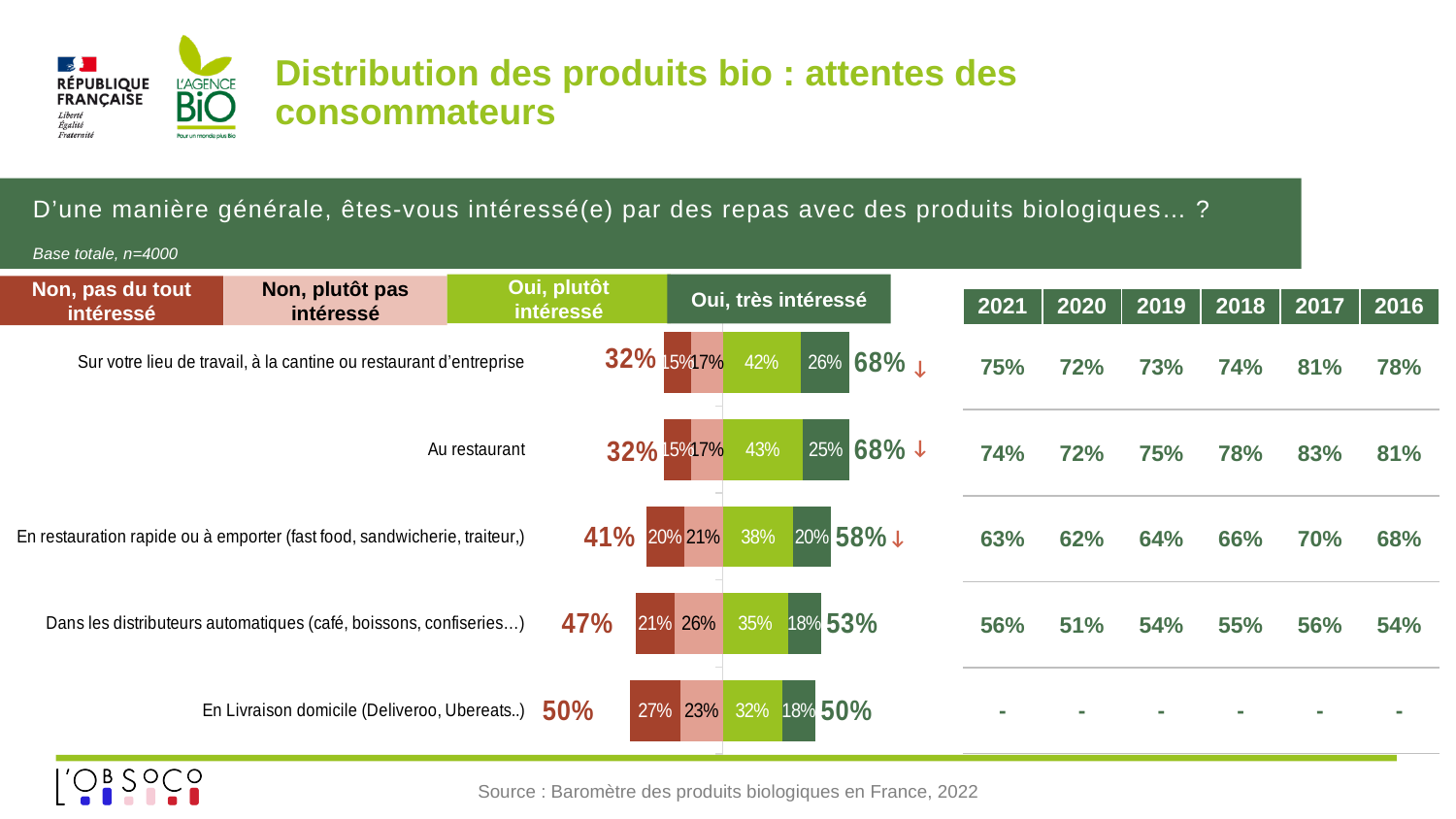
Which category has the lowest 'Oui, plutôt intéressé' value? En Livraison domicile (Deliveroo, Ubereats..) Going from the top category to the bottom category, does the 'Oui, très intéressé' value rise or fall? Fall How many categories (places) are shown in the stacked bar chart? 5 Which has the larger 'Non, plutôt pas intéressé' value: 'Dans les distributeurs automatiques' or 'En Livraison domicile'? Dans les distributeurs automatiques What is the combined 'Oui' (plutôt + très intéressé) total for 'En restauration rapide ou à emporter (fast food, sandwicherie, traiteur,)'? 58% How many series does the legend of the stacked bar chart list? 4 What is the 'Oui, plutôt intéressé' value for 'Au restaurant'? 43% What is the 'Non, pas du tout intéressé' value for 'En Livraison domicile (Deliveroo, Ubereats..)'? 27% Which colour represents 'Oui, plutôt intéressé' in the legend? Light green What kind of chart is used to show the responses to the question about interest in meals with organic products? Bar chart What is the difference in the 'Oui, plutôt intéressé' value between 'Au restaurant' and 'Dans les distributeurs automatiques (café, boissons, confiseries…)'? 8 percentage points Which category has the highest 'Oui, très intéressé' value? Sur votre lieu de travail, à la cantine ou restaurant d'entreprise